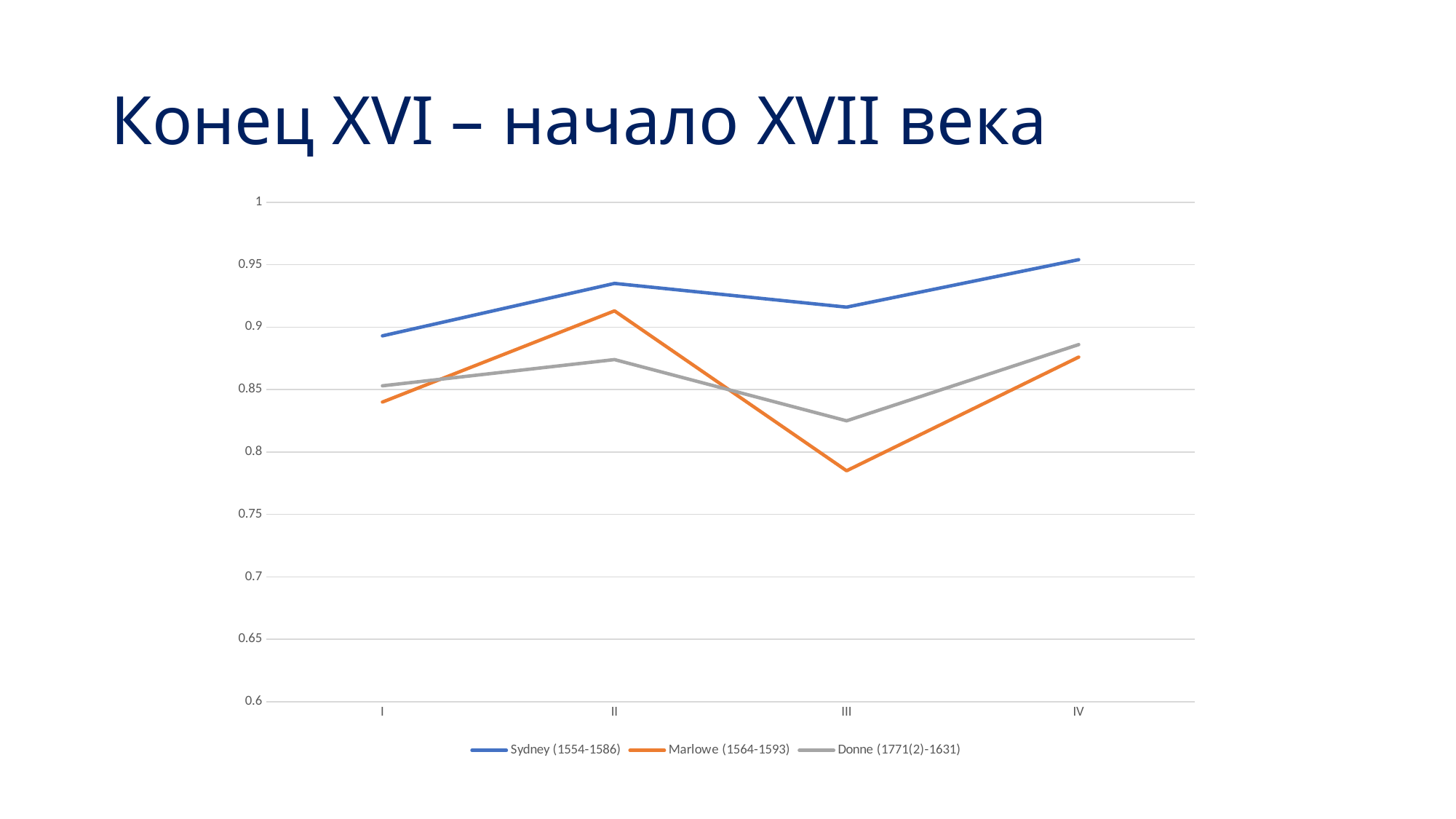
Does the Marlowe (1564-1593) line rise or fall from II to III? fall What kind of chart is shown on the slide? line chart How many series does the legend list? 3 At which x-axis point does the Donne (1771(2)-1631) line reach its lowest value? III Is the value for Sydney (1554-1586) at II greater or less than 0.9? greater Is the value for Donne (1771(2)-1631) at III greater or less than 0.85? less How many points are there along the x axis? 4 Is the value for Marlowe (1564-1593) at III greater or less than 0.8? less At II, which series has the higher value: Marlowe (1564-1593) or Donne (1771(2)-1631)? Marlowe (1564-1593) At which x-axis point does the Sydney (1554-1586) line reach its highest value? IV At III, which series has the higher value: Sydney (1554-1586) or Marlowe (1564-1593)? Sydney (1554-1586) At which x-axis point does the Marlowe (1564-1593) line reach its lowest value? III